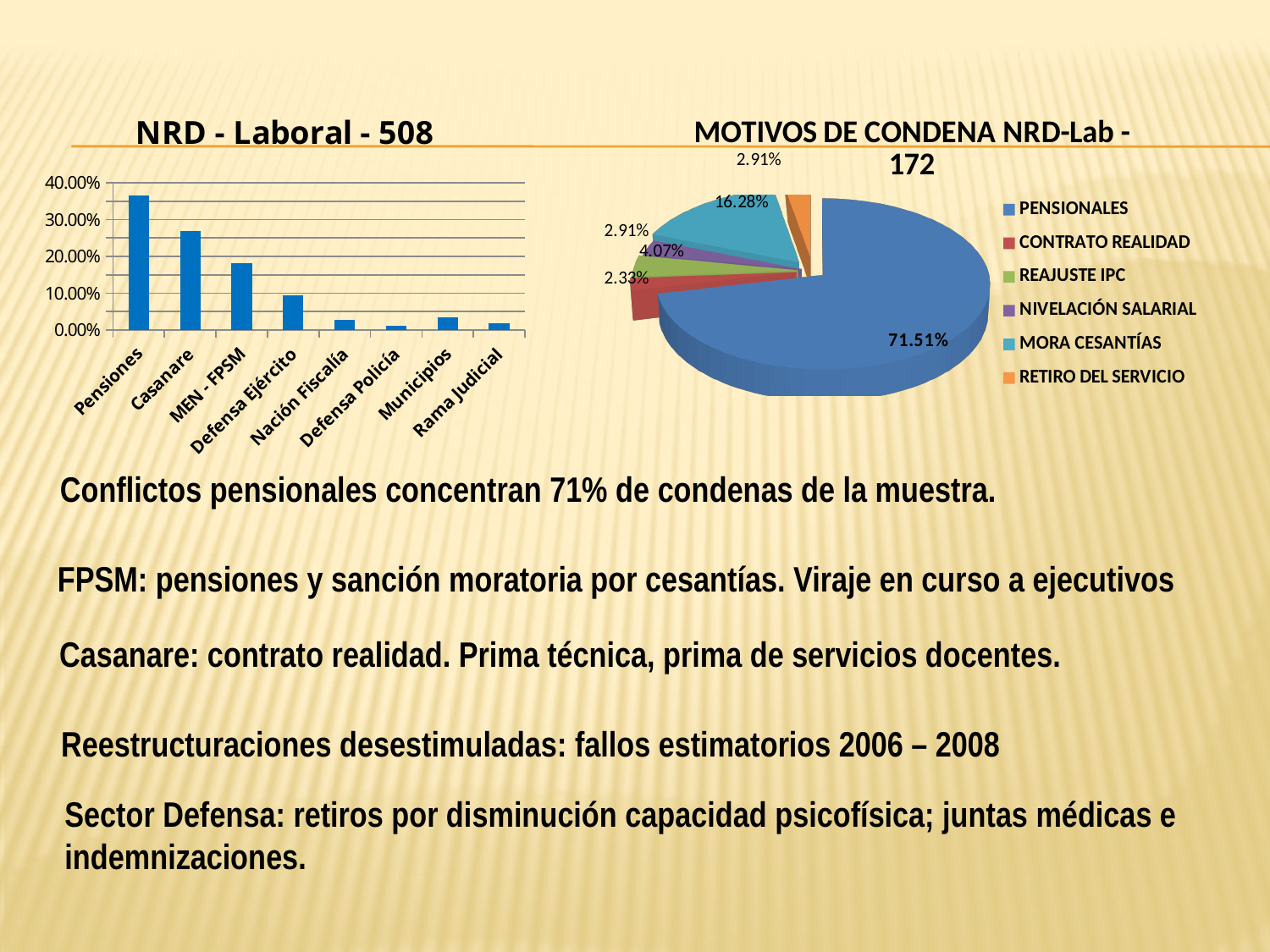
In the chart titled 'MOTIVOS DE CONDENA NRD-Lab - 172', how many entries does the legend list? 6 In the chart titled 'MOTIVOS DE CONDENA NRD-Lab - 172', what share does PENSIONALES have? 71.51% What kind of chart is the chart titled 'MOTIVOS DE CONDENA NRD-Lab - 172'? Pie chart In the chart titled 'MOTIVOS DE CONDENA NRD-Lab - 172', what share does MORA CESANTÍAS have? 16.28% In the chart titled 'NRD - Laboral - 508', how many categories are shown on the x axis? 8 What kind of chart is the chart titled 'NRD - Laboral - 508'? Bar chart In the chart titled 'NRD - Laboral - 508', which category has the lowest value? Defensa Policía In the chart titled 'NRD - Laboral - 508', which is larger, the value for Casanare or the value for MEN - FPSM? Casanare In the chart titled 'MOTIVOS DE CONDENA NRD-Lab - 172', what is the difference between the PENSIONALES share and the MORA CESANTÍAS share? 55.23% In the chart titled 'NRD - Laboral - 508', is the value for MEN - FPSM greater or less than 20.00%? less In the chart titled 'NRD - Laboral - 508', which category has the highest value? Pensiones In the chart titled 'NRD - Laboral - 508', is the value for Pensiones greater or less than 30.00%? greater